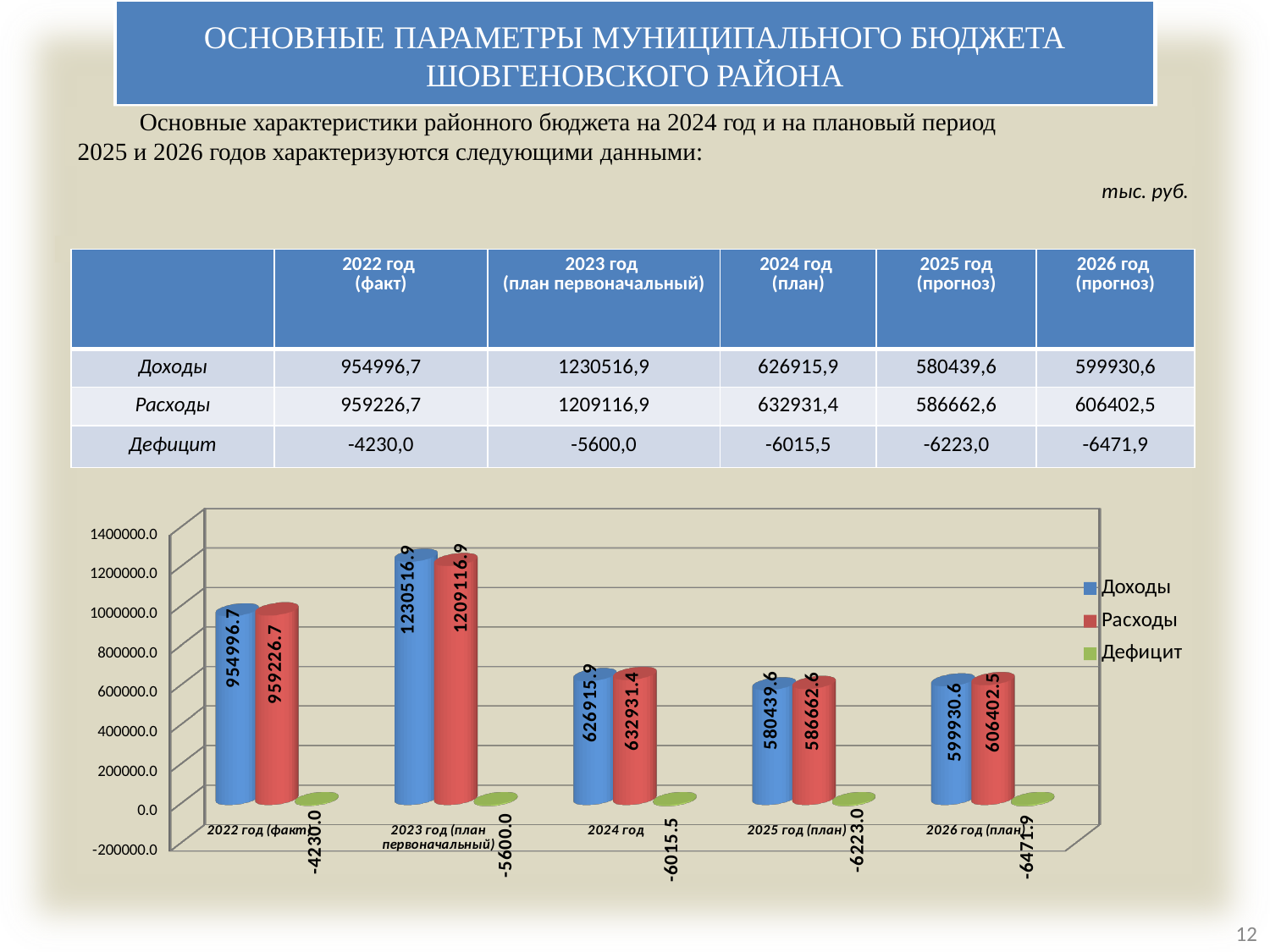
Is the Доходы value for 2024 год greater or less than 800000.0 in the chart? less How many series does the chart legend list? 3 In which year category is Доходы highest in the chart? 2023 год (план первоначальный) What is the value of Доходы for 2023 год (план первоначальный) in the chart? 1230516.9 What is the difference between Расходы and Доходы for 2022 год (факт) in the chart? 4230.0 How many year categories are plotted along the x axis of the chart? 5 Which is larger in the chart for 2023 год (план первоначальный): Доходы or Расходы? Доходы Which series is shown in red in the chart? Расходы In which year category is Расходы lowest in the chart? 2025 год (план) What kind of chart is shown on the slide? bar chart What is the value of Дефицит for 2026 год (план) in the chart? -6471.9 What is the value of Расходы for 2024 год in the chart? 632931.4